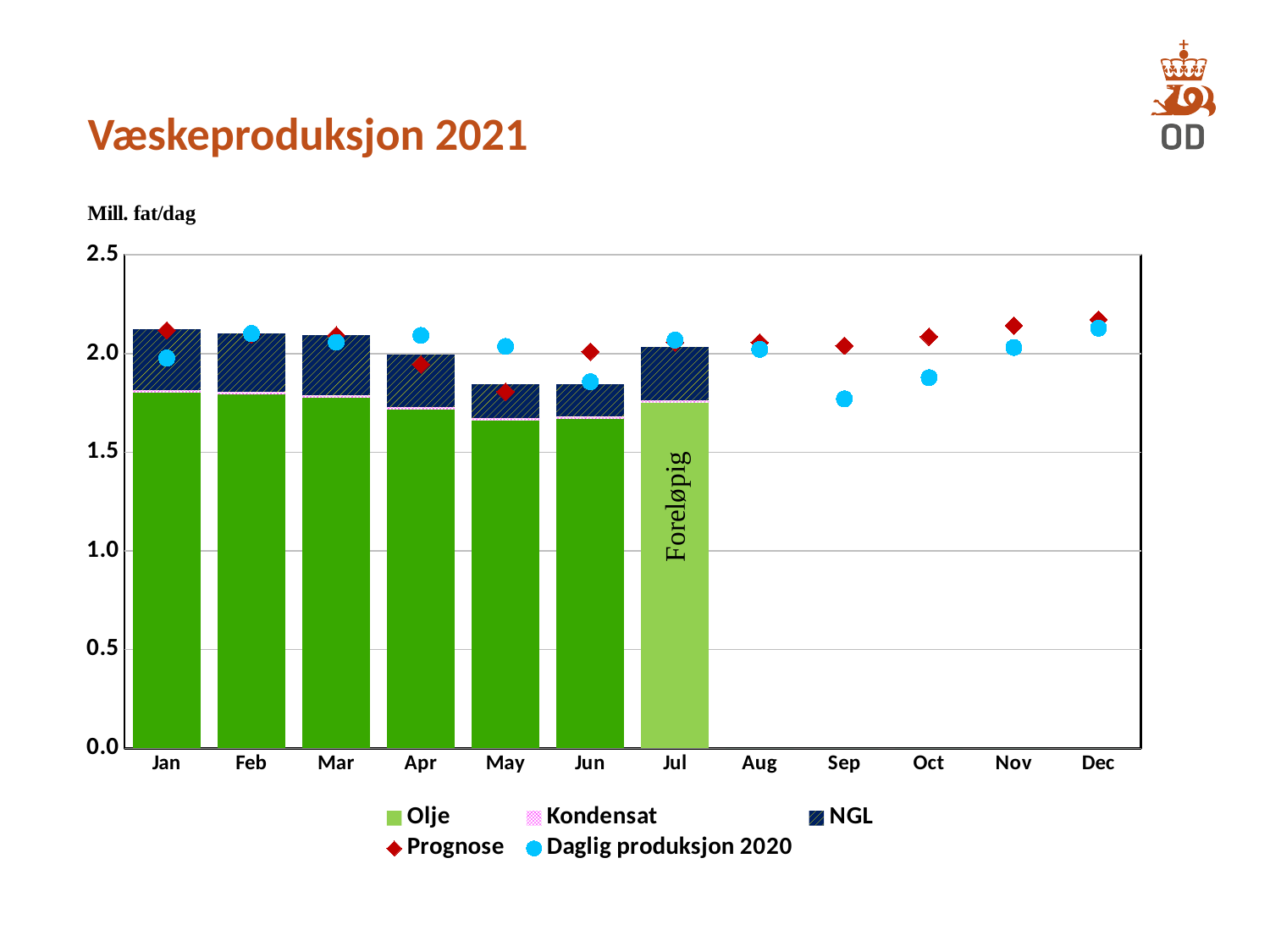
Is the Prognose value for Dec greater or less than 2.0? greater How many months are shown on the x axis? 12 Is the total of the stacked bar for Jan greater or less than 2.0? greater How many months have a stacked bar plotted? 7 How many series does the legend list? 5 What kind of chart is shown on the slide? combination bar and line chart What is the title of the chart? Væskeproduksjon 2021 Do the Prognose values rise or fall from Aug to Dec? rise Which month has the lowest Daglig produksjon 2020 value? Sep Is the total of the stacked bar for May greater or less than 2.0? less Which stacked bar is taller, Jan or May? Jan